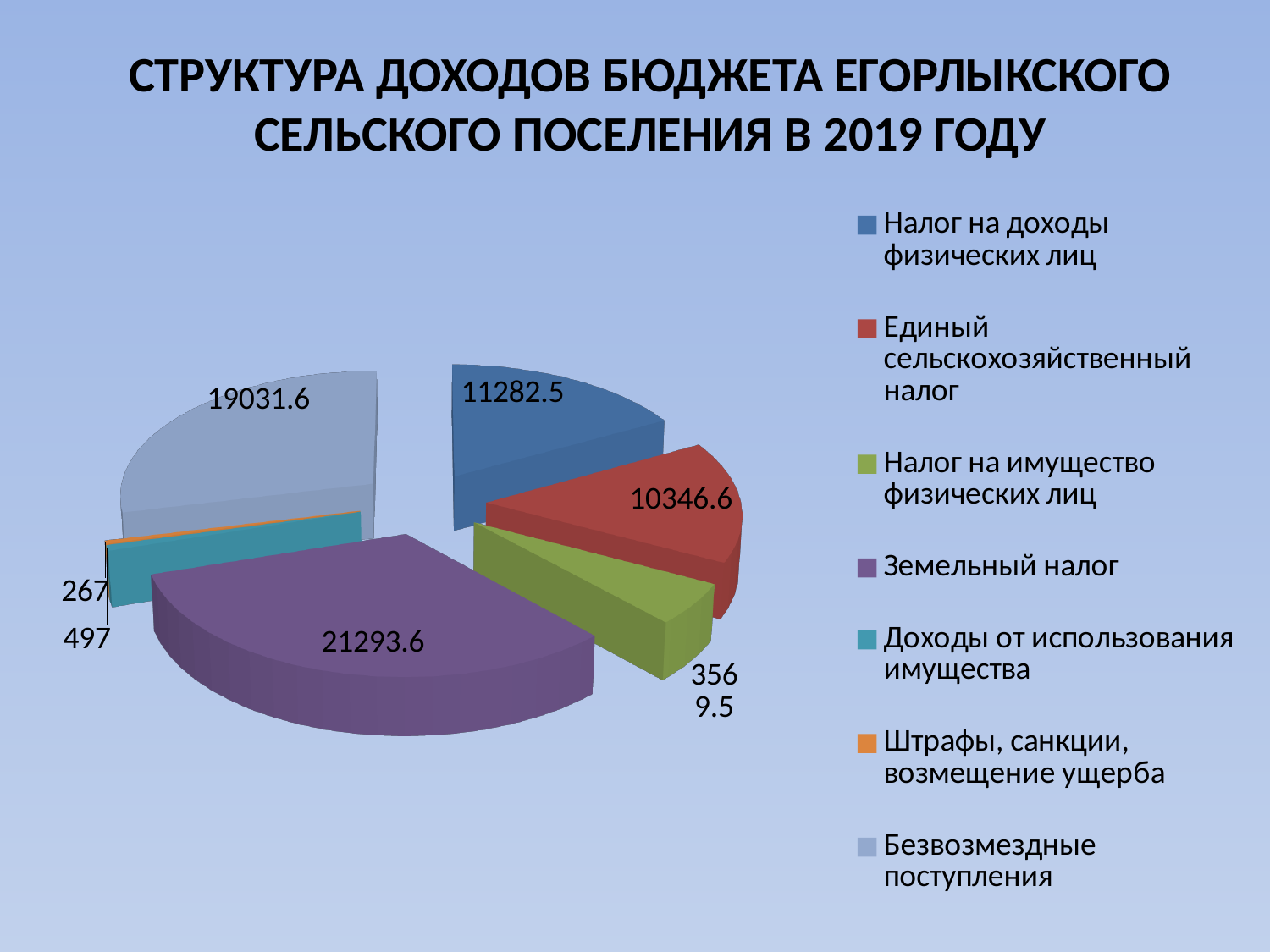
Which category has the smallest slice of the pie? Штрафы, санкции, возмещение ущерба What is the value for Безвозмездные поступления? 19031.6 Which is larger: Налог на доходы физических лиц or Единый сельскохозяйственный налог? Налог на доходы физических лиц What is the value for Единый сельскохозяйственный налог? 10346.6 What type of chart is shown on the slide? Pie chart Which category has the largest slice of the pie? Земельный налог What is the value for Земельный налог? 21293.6 What is the value for Налог на доходы физических лиц? 11282.5 How many categories does the legend list? 7 What is the difference between the values for Земельный налог and Безвозмездные поступления? 2262 What is the title of the slide? СТРУКТУРА ДОХОДОВ БЮДЖЕТА ЕГОРЛЫКСКОГО СЕЛЬСКОГО ПОСЕЛЕНИЯ В 2019 ГОДУ What is the difference between the values for Налог на доходы физических лиц and Единый сельскохозяйственный налог? 935.9